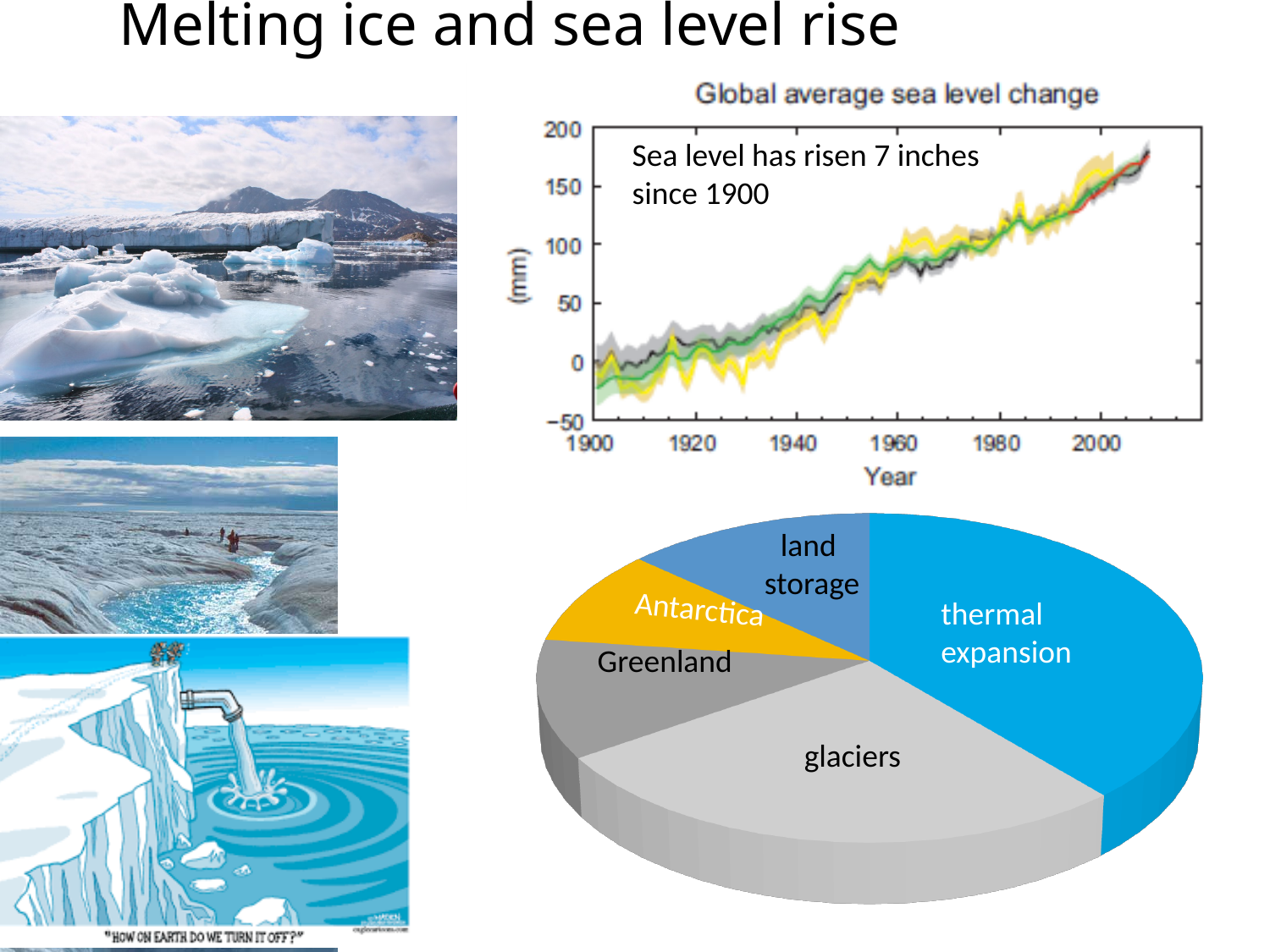
According to the text on the 'Global average sea level change' chart, how much has sea level risen since 1900? 7 inches In the pie chart at the bottom right of the slide, which slice is the largest? thermal expansion In the 'Global average sea level change' chart, is the value at the end of the series (around 2010) greater or less than 150? greater In the pie chart at the bottom right of the slide, which slice is the smallest? Antarctica In the 'Global average sea level change' chart, is the value around the year 2000 greater or less than 100? greater What is the label of the y axis in the 'Global average sea level change' chart? (mm) What kind of chart is the 'Global average sea level change' chart? line chart What kind of chart is the chart at the bottom right of the slide with slices labelled thermal expansion and glaciers? pie chart In the 'Global average sea level change' chart, do the values rise or fall from 1900 to 2010? rise In the 'Global average sea level change' chart, is the value around the year 1920 greater or less than 50? less In the pie chart at the bottom right of the slide, which slice is larger, Greenland or Antarctica? Greenland How many slices does the pie chart at the bottom right of the slide have? 5